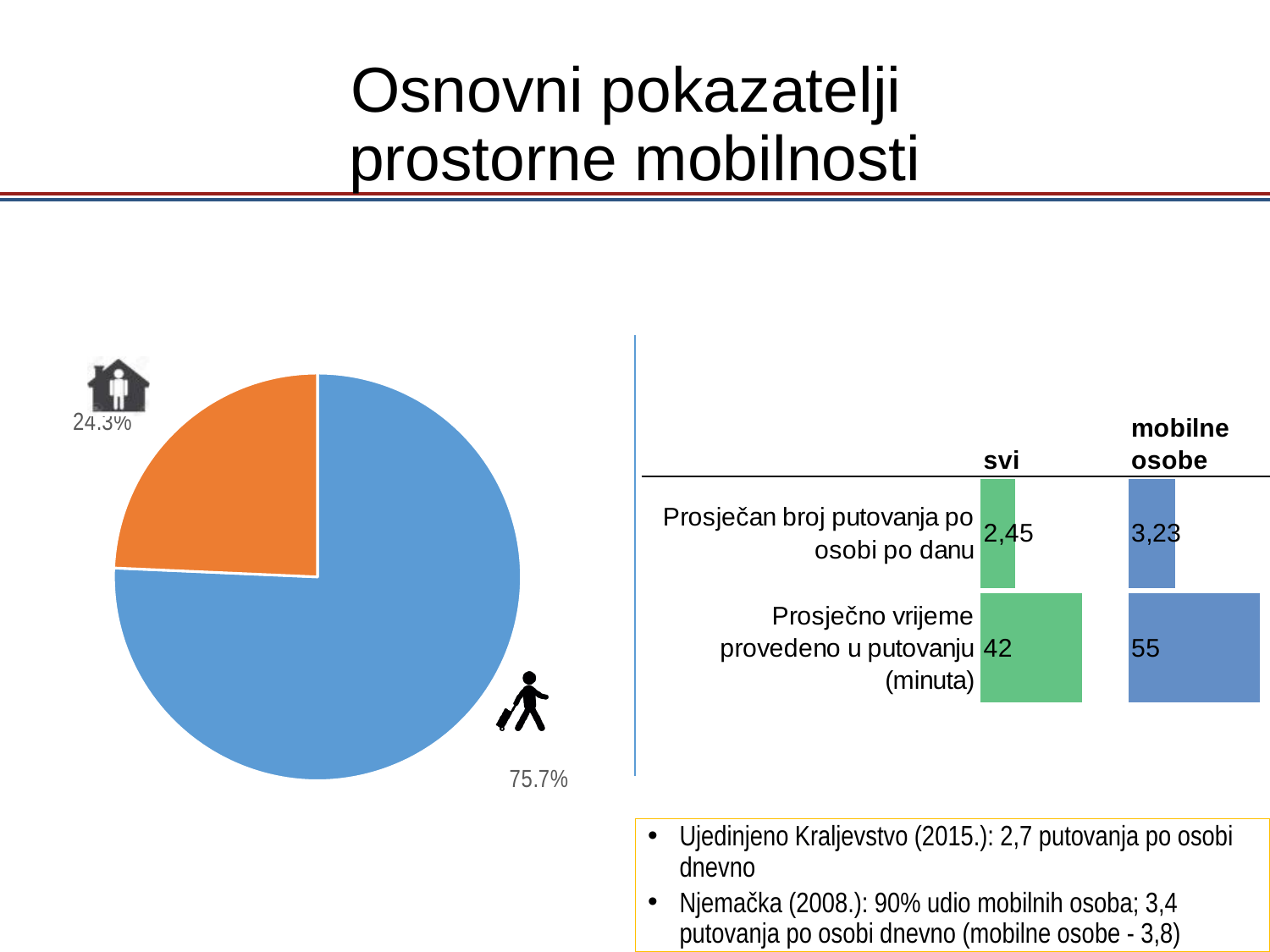
In the bar chart on the right, what is the value of 'Prosječno vrijeme provedeno u putovanju (minuta)' for 'svi'? 42 In the bar chart on the right, which group has the higher 'Prosječan broj putovanja po osobi po danu', 'svi' or 'mobilne osobe'? mobilne osobe In the bar chart on the right, what is the value of 'Prosječno vrijeme provedeno u putovanju (minuta)' for 'mobilne osobe'? 55 In the bar chart on the right, what is the value of 'Prosječan broj putovanja po osobi po danu' for 'mobilne osobe'? 3,23 In the pie chart on the left, what share does the blue slice represent? 75.7% In the bar chart on the right, what is the value of 'Prosječan broj putovanja po osobi po danu' for 'svi'? 2,45 How many slices does the pie chart on the left have? 2 In the pie chart on the left, what share does the orange slice represent? 24.3% In the bar chart on the right, what is the difference in 'Prosječno vrijeme provedeno u putovanju (minuta)' between 'mobilne osobe' and 'svi'? 13 What type of chart is shown on the left of the slide? pie chart In the pie chart on the left, which slice is larger, the blue one or the orange one? the blue one In the bar chart on the right, how many series (column groups) are shown? 2